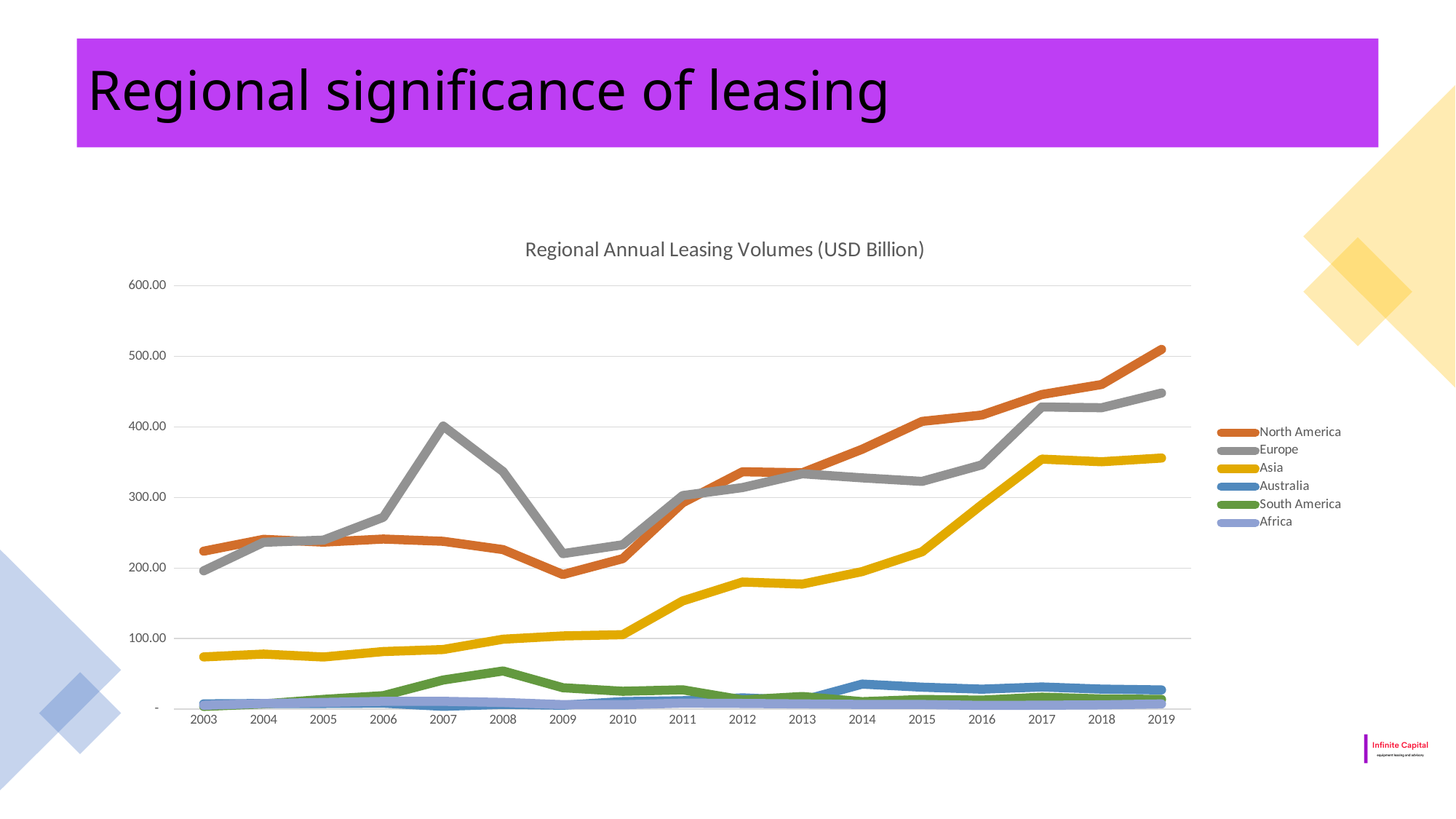
Is the value for North America in 2019 greater or less than 400.00? greater How many years are shown along the x axis? 17 What is the title of the chart? Regional Annual Leasing Volumes (USD Billion) Which is larger in 2007, Europe or North America? Europe What kind of chart is shown on the slide? line chart Which region has the highest leasing volume in 2019? North America Which is larger in 2019, North America or Europe? North America Is the value for Europe in 2007 greater or less than 300.00? greater Is the value for Asia in 2003 greater or less than 100.00? less How many series does the legend list? 6 Does the Europe line rise or fall from 2007 to 2009? falls Does the Asia line rise or fall from 2010 to 2017? rises